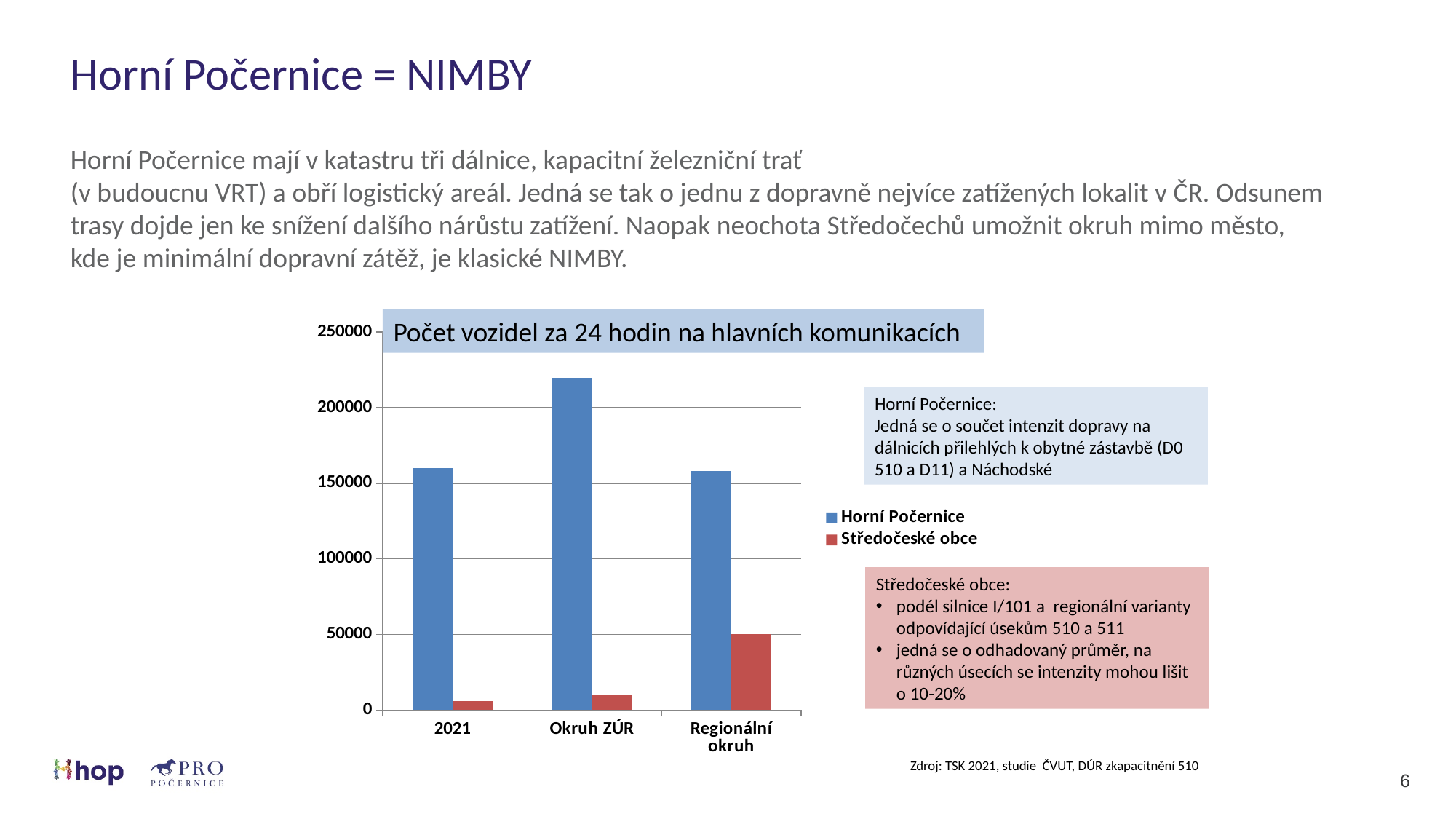
What kind of chart is shown on the slide? bar chart Is the Středočeské obce value for Okruh ZÚR greater or less than 50000? less Is the Horní Počernice value for Okruh ZÚR greater or less than 200000? greater Is the Horní Počernice value for 2021 greater or less than 150000? greater For which category is the Horní Počernice value highest? Okruh ZÚR How many categories are shown on the x axis of the chart? 3 What is the title of the chart? Počet vozidel za 24 hodin na hlavních komunikacích How many series does the chart legend list? 2 For Regionální okruh, which series has the larger value, Horní Počernice or Středočeské obce? Horní Počernice For which category is the Středočeské obce value highest? Regionální okruh Do the Středočeské obce values rise or fall from 2021 to Regionální okruh along the x axis? rise For which category is the Středočeské obce value lowest? 2021